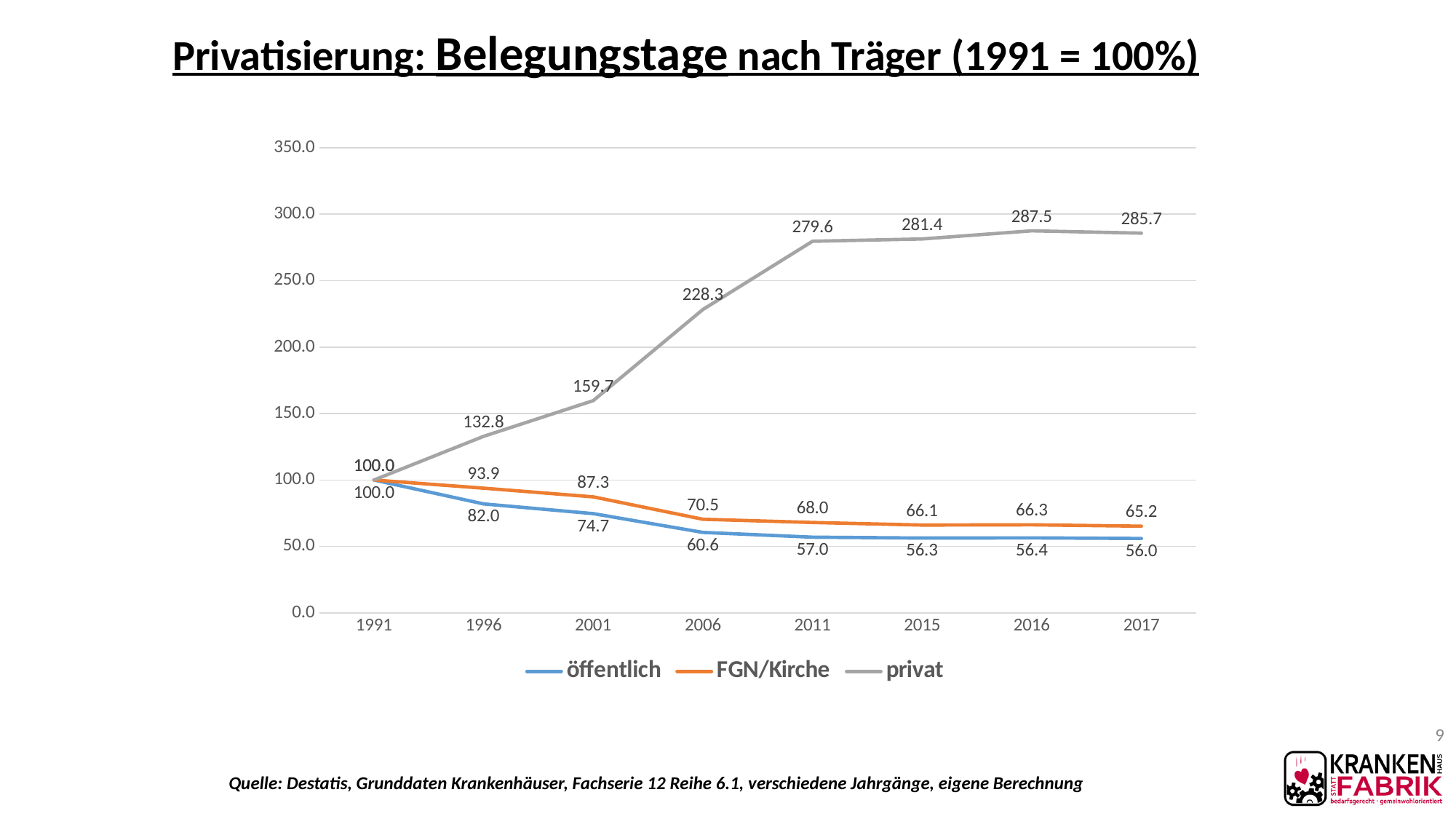
How many years are shown on the x axis? 8 In which year is the öffentlich series at its lowest value? 2017 What is the difference between the privat and öffentlich values in 2017? 229.7 What is the value for FGN/Kirche in 2001? 87.3 Does the öffentlich series rise or fall from 1991 to 2017? fall What is the value for privat in 2016? 287.5 What kind of chart is shown on the slide? line chart Is the value for privat in 2006 greater or less than 200.0? greater In which year does the privat series reach its highest value? 2016 Which series has the larger value in 2011, FGN/Kirche or öffentlich? FGN/Kirche How many series does the legend list? 3 What is the value for öffentlich in 2006? 60.6